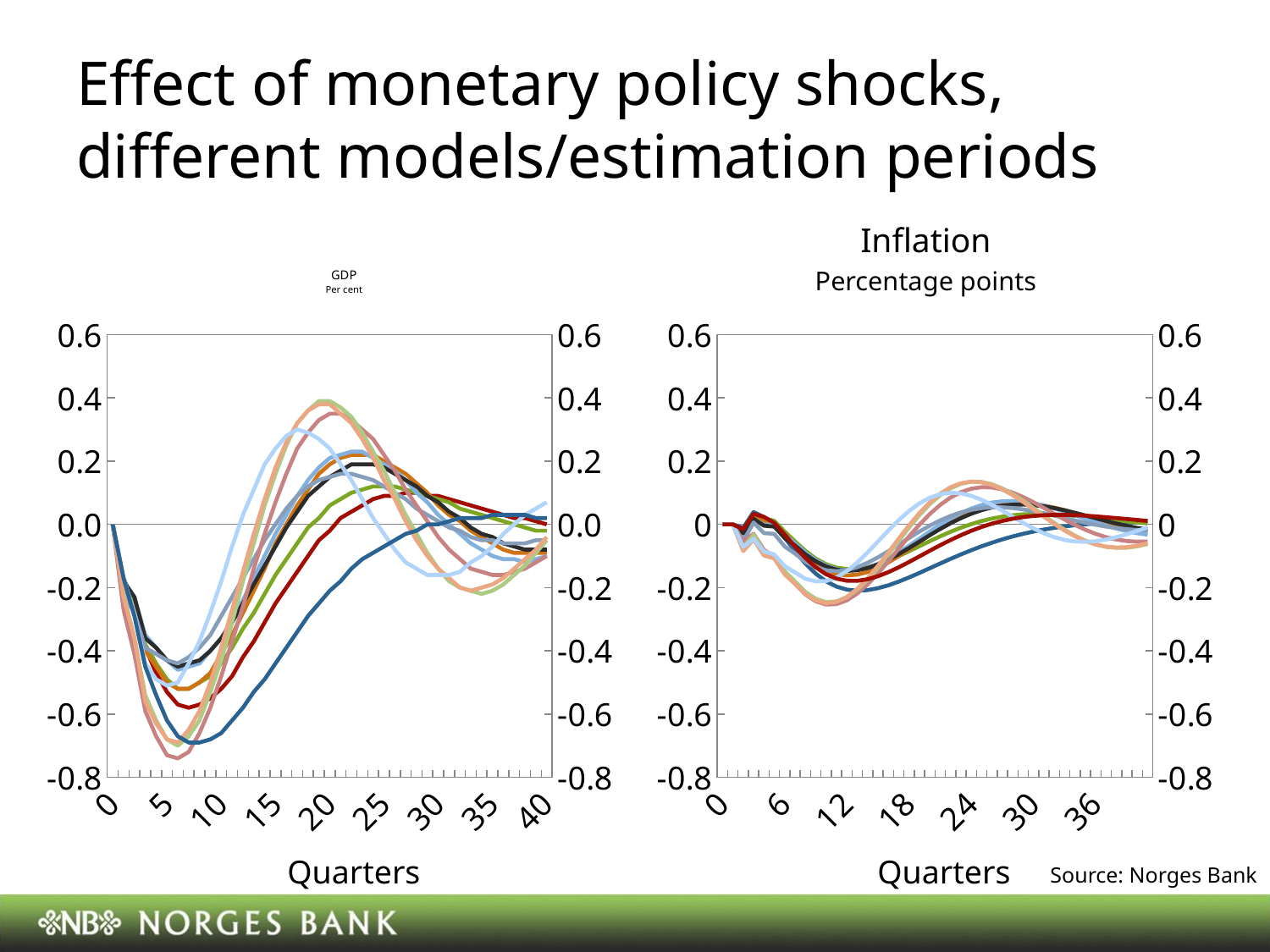
What is the lowest value shown on the vertical axis of the Inflation chart? -0.8 What kind of chart is the Inflation chart on the right? line chart In the GDP chart, is the highest value reached by any line greater or less than 0.2? greater What unit is shown under the title of the GDP chart? Per cent In the Inflation chart, is the highest value reached by any line greater or less than 0.2? less What unit is shown under the title of the Inflation chart? Percentage points What is the largest tick label on the horizontal axis of the GDP chart? 40 What kind of chart is the GDP chart on the left? line chart In the Inflation chart, is the lowest value reached by any line greater or less than -0.4? greater What is the largest tick label on the horizontal axis of the Inflation chart? 36 What is the highest value shown on the vertical axis of the GDP chart? 0.6